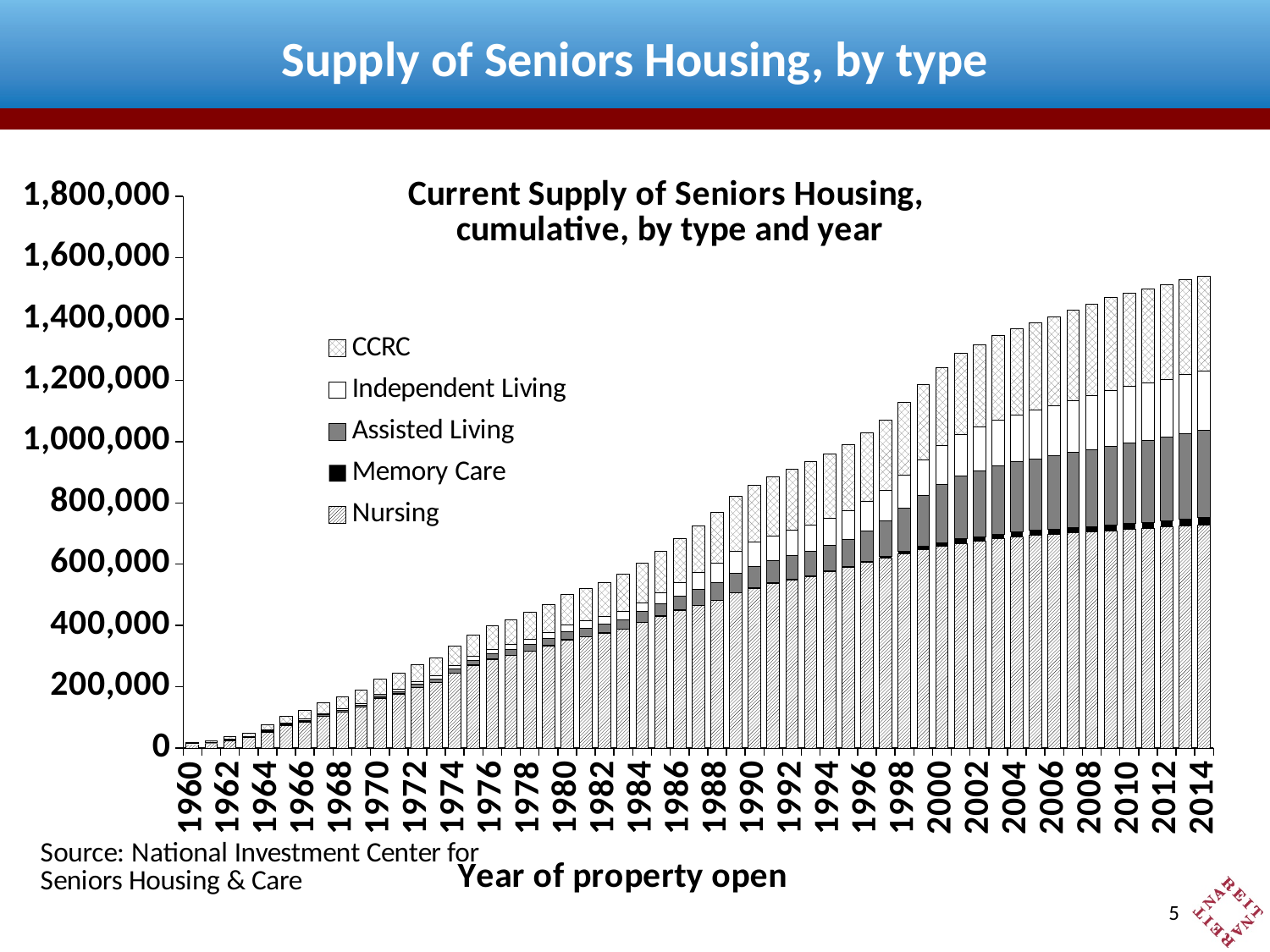
What is the title of the chart? Current Supply of Seniors Housing, cumulative, by type and year What is the x-axis title of the chart? Year of property open Is the total cumulative supply for 1970 greater or less than 400,000? less How many series does the legend list? 5 Do the total bar heights rise or fall from 1960 to 2014? rise What kind of chart is shown on the slide? stacked bar chart Is the total cumulative supply for 2014 greater or less than 1,400,000? greater Which year has the larger total cumulative supply, 1980 or 2000? 2000 Which year has the highest total cumulative supply? 2014 Which year has the lowest total cumulative supply? 1960 Is the total cumulative supply for 1990 greater or less than 800,000? greater